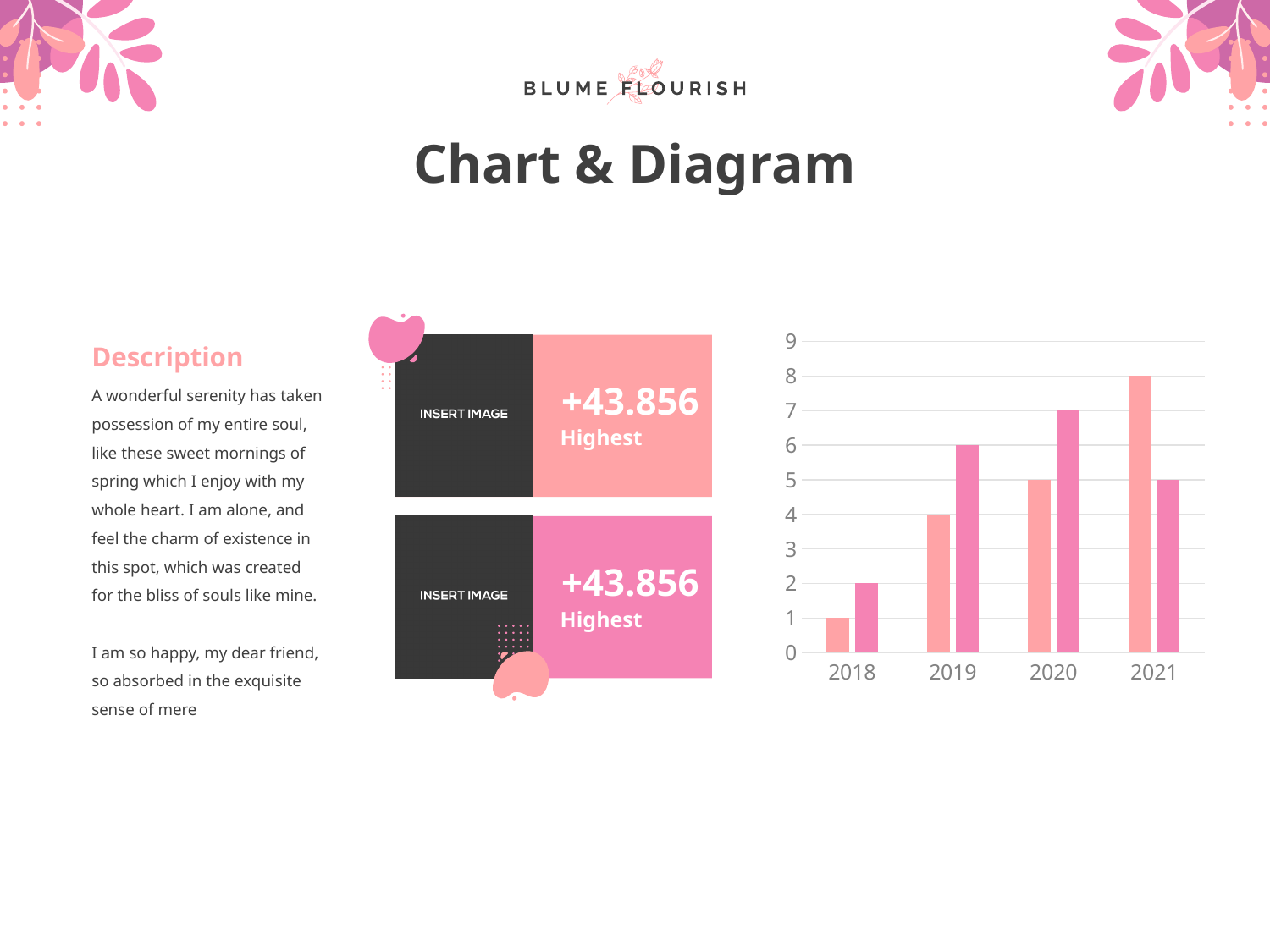
In which year is the light pink bar the highest? 2021 Do the light pink bars rise or fall from 2018 to 2021? rise For 2021, which bar is taller, the light pink bar or the darker pink bar? the light pink bar What kind of chart is shown on the right of the slide? bar chart What is the value of the darker pink bar for 2021? 5 What is the difference between the darker pink bar and the light pink bar for 2020? 2 How many bars are shown for each year in the chart? 2 What is the value of the darker pink bar for 2019? 6 In which year is the darker pink bar the lowest? 2018 Is the value of the light pink bar for 2021 greater or less than 5? greater What is the value of the light pink bar for 2018? 1 How many years are shown on the x axis of the bar chart? 4